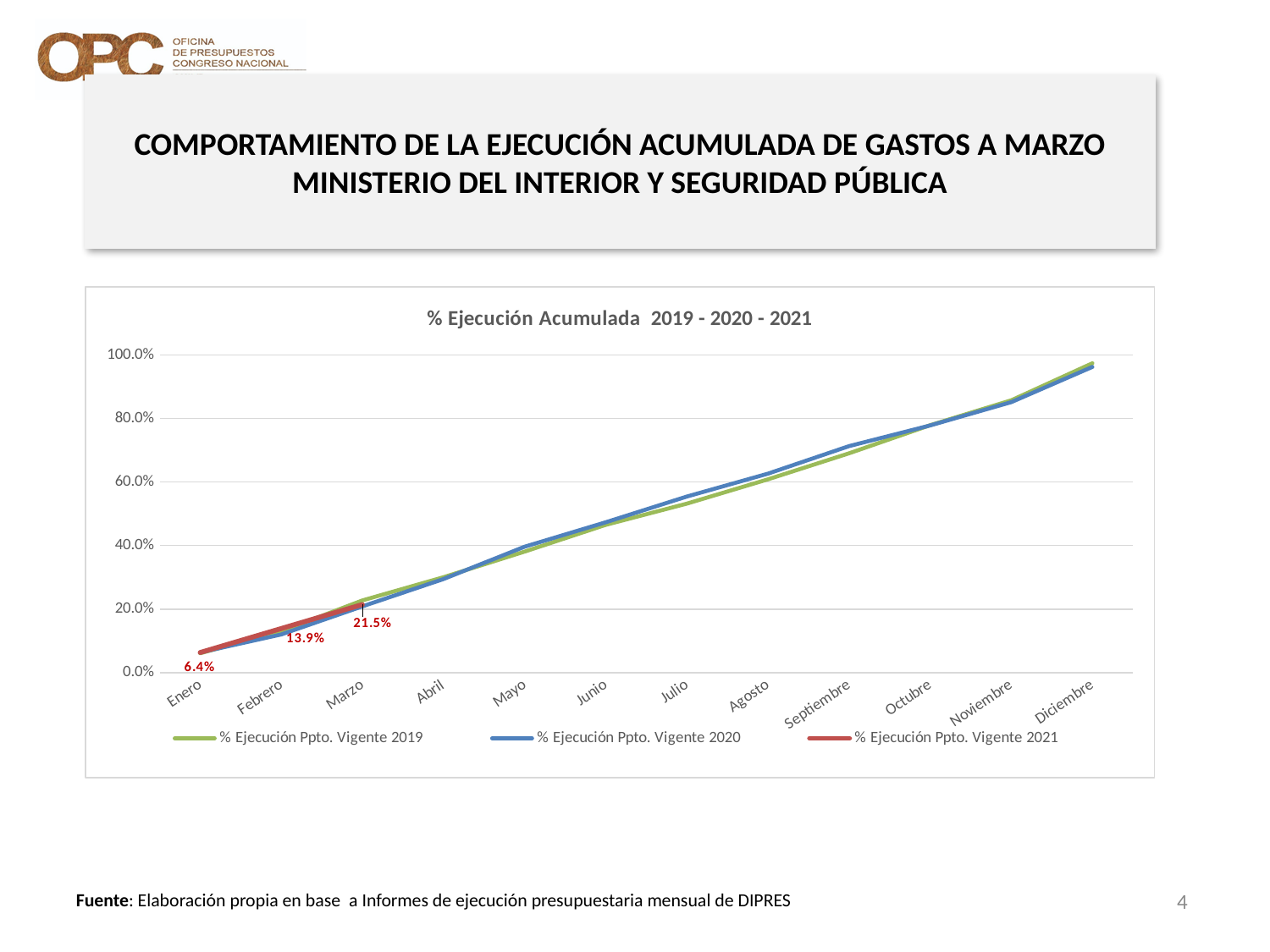
What is the title of the chart? % Ejecución Acumulada 2019 - 2020 - 2021 What is the difference between the 2021 values for Marzo and Febrero? 7.6% What is the value of % Ejecución Ppto. Vigente 2021 for Enero? 6.4% How many series does the legend list? 3 Is the value for % Ejecución Ppto. Vigente 2020 in Diciembre greater or less than 80.0%? greater Do the values for % Ejecución Ppto. Vigente 2020 rise or fall from Enero to Diciembre? Rise How many months are shown on the x axis? 12 What kind of chart is shown on the slide? Line chart What is the value of % Ejecución Ppto. Vigente 2021 for Febrero? 13.9% What is the difference between the 2021 values for Febrero and Enero? 7.5% Which month has the highest value for the % Ejecución Ppto. Vigente 2021 series? Marzo What is the value of % Ejecución Ppto. Vigente 2021 for Marzo? 21.5%